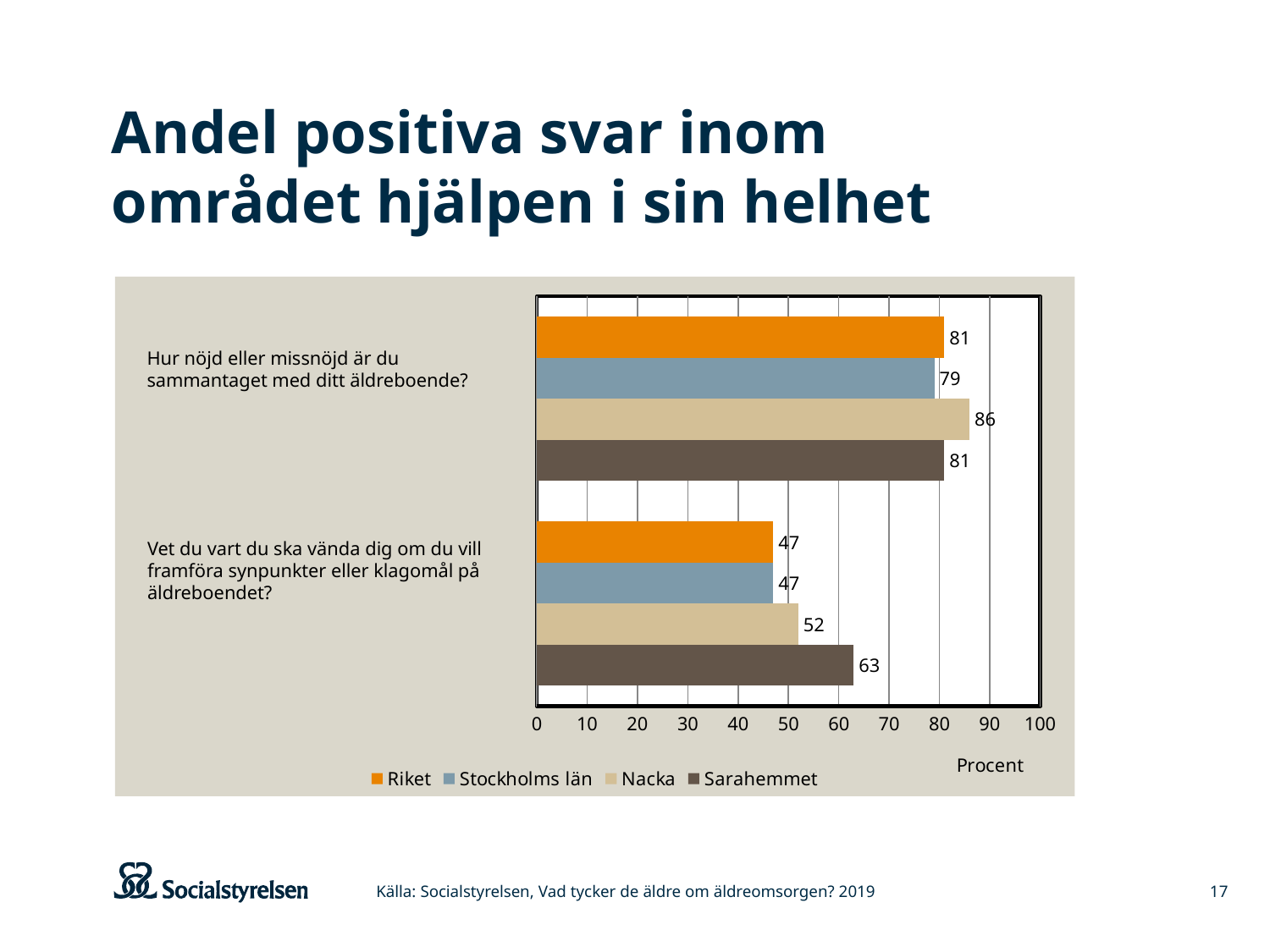
Which is larger on the question "Vet du vart du ska vända dig om du vill framföra synpunkter eller klagomål på äldreboendet?": Nacka or Stockholms län? Nacka What kind of chart is shown on the slide? Bar chart Which series has the highest value on the question "Hur nöjd eller missnöjd är du sammantaget med ditt äldreboende?"? Nacka What is the label of the horizontal axis? Procent What is the difference between Nacka and Stockholms län on the question "Hur nöjd eller missnöjd är du sammantaget med ditt äldreboende?"? 7 Which series has the highest value on the question "Vet du vart du ska vända dig om du vill framföra synpunkter eller klagomål på äldreboendet?"? Sarahemmet What is the difference between Sarahemmet and Nacka on the question "Vet du vart du ska vända dig om du vill framföra synpunkter eller klagomål på äldreboendet?"? 11 What is the value for Stockholms län on the question "Hur nöjd eller missnöjd är du sammantaget med ditt äldreboende?"? 79 What is the value for Riket on the question "Vet du vart du ska vända dig om du vill framföra synpunkter eller klagomål på äldreboendet?"? 47 What is the value for Sarahemmet on the question "Vet du vart du ska vända dig om du vill framföra synpunkter eller klagomål på äldreboendet?"? 63 What is the value for Nacka on the question "Hur nöjd eller missnöjd är du sammantaget med ditt äldreboende?"? 86 How many series does the legend list? 4